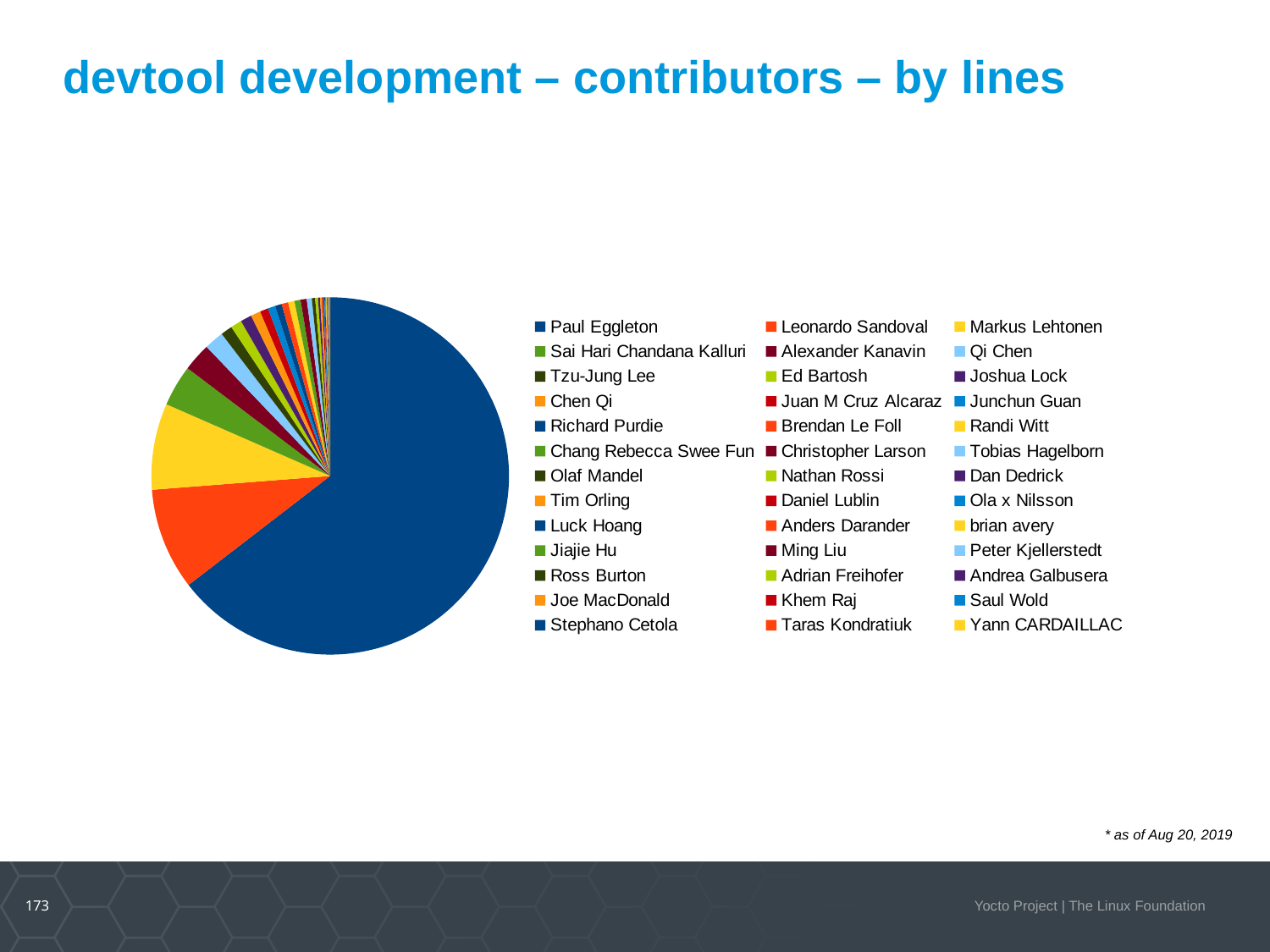
How many contributors are listed in the legend? 39 Does Paul Eggleton's slice account for more or less than half of the pie? more Which contributor has the largest slice of the pie? Paul Eggleton Which contributor is listed first in the legend? Paul Eggleton Which slice is larger, Paul Eggleton's or Leonardo Sandoval's? Paul Eggleton Which slice is larger, Leonardo Sandoval's or Chen Qi's? Leonardo Sandoval What is the title of the slide containing the pie chart? devtool development – contributors – by lines What kind of chart is shown on the slide? pie chart Which slice is larger, Sai Hari Chandana Kalluri's or Tzu-Jung Lee's? Sai Hari Chandana Kalluri